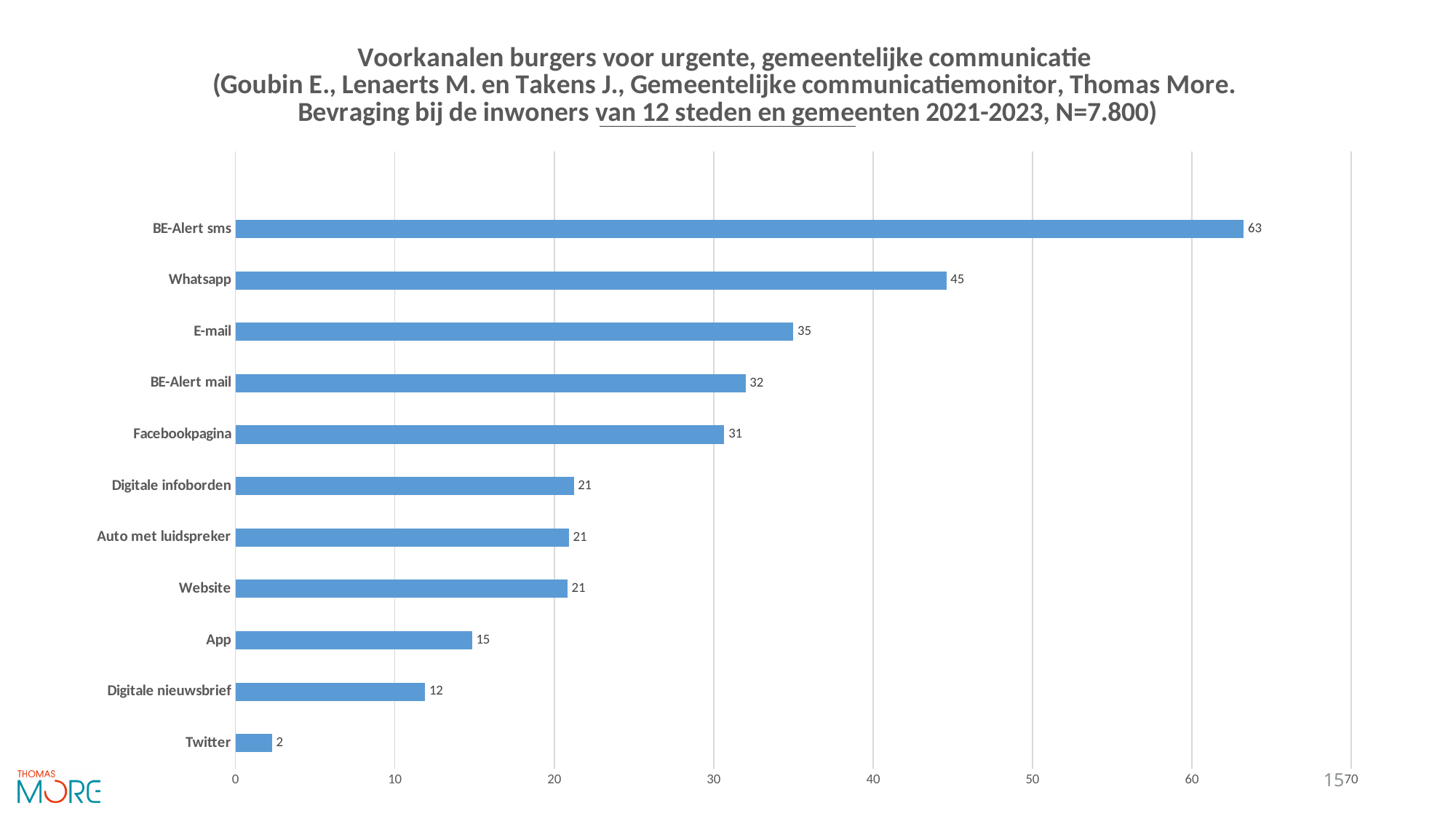
Is the value for Facebookpagina greater or less than 40? less Which is larger, the value for E-mail or the value for BE-Alert mail? E-mail What kind of chart is shown on the slide? bar chart Which category has the lowest value? Twitter What is the value for Digitale nieuwsbrief? 12 What is the value for BE-Alert sms? 63 How many categories have a value of 21? 3 What is the value for Whatsapp? 45 What is the difference between the values for BE-Alert sms and Whatsapp? 18 What is the difference between the values for E-mail and App? 20 Which category has the highest value? BE-Alert sms How many categories are shown in the chart? 11